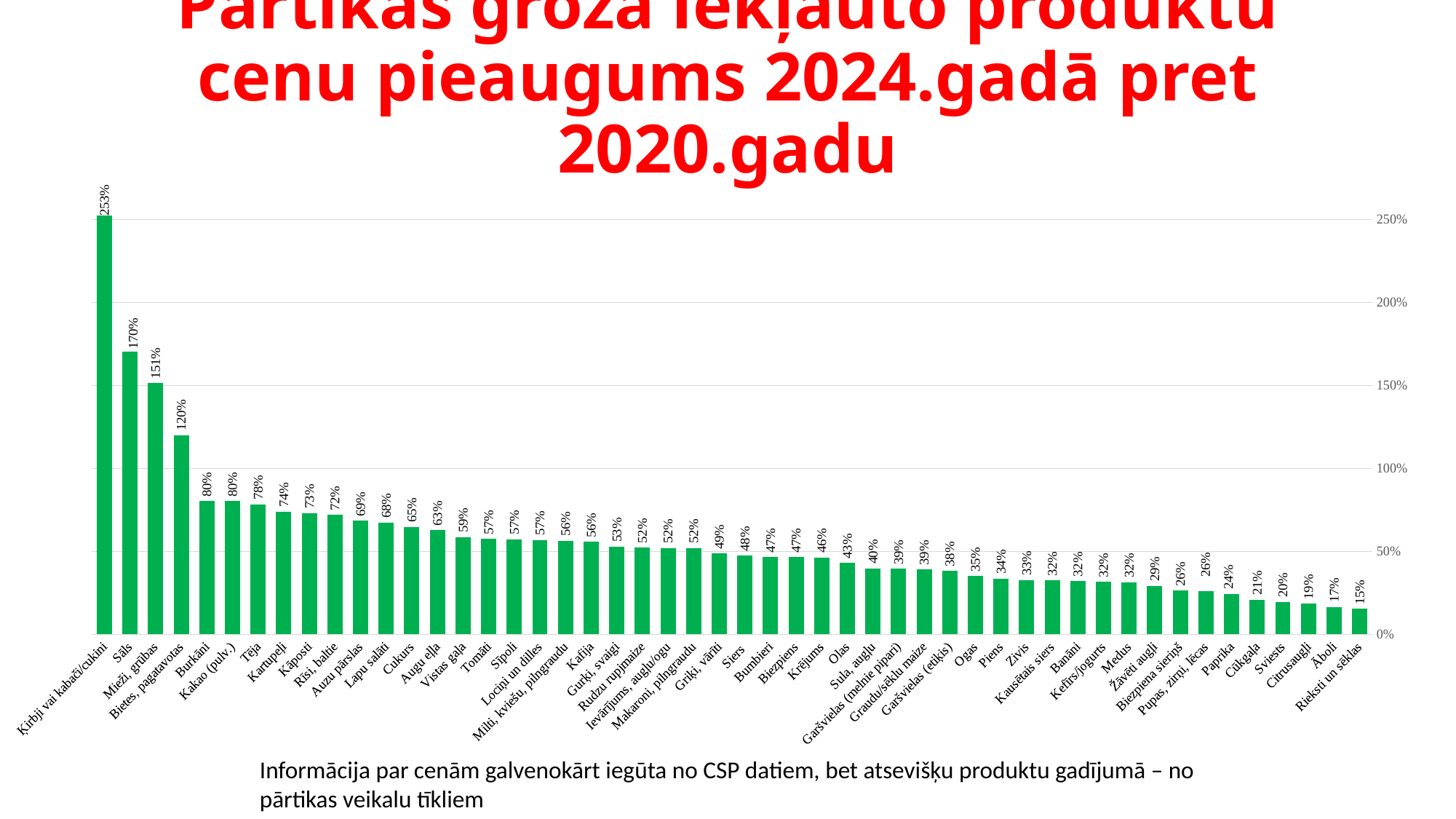
What is the value shown for Piens? 34% Is the value for Bietes, pagatavotas greater or less than 100%? greater What is the difference between the values for Sāls and Mieži, grūbas? 19% Do the values rise or fall from left to right along the x axis? Fall What colour are the bars in the chart? Green What kind of chart is shown on the slide? Bar chart What is the value shown for Kartupeļi? 74% How many products are shown in the chart? 50 What is the price increase shown for Sāls? 170% Which product has the highest price increase? Ķirbji vai kabači/cukini Which has a larger value, Cukurs or Olas? Cukurs Which product has the lowest price increase? Rieksti un sēklas